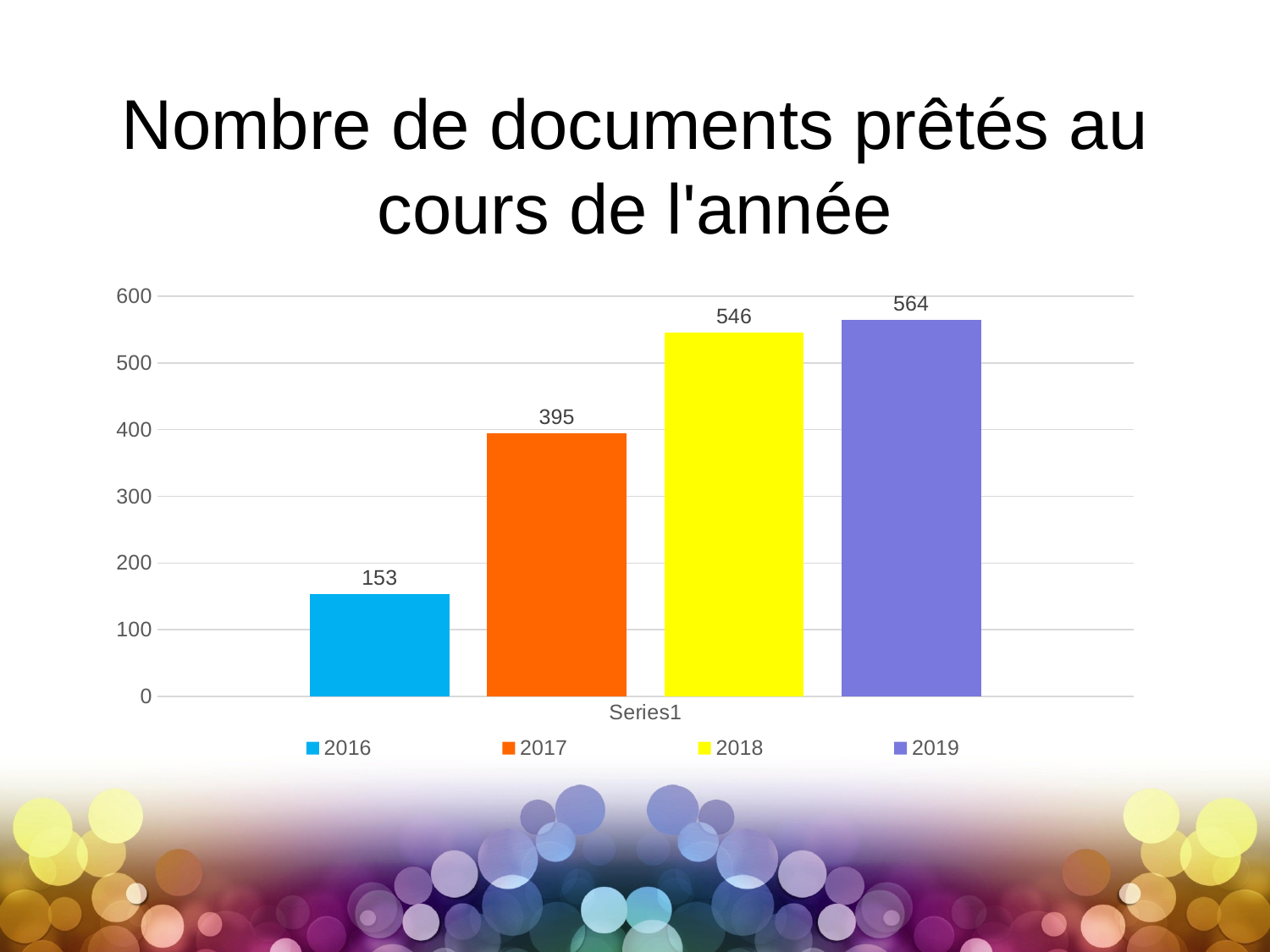
What is the difference between the values for 2017 and 2016? 242 What is the value for 2016? 153 What is the difference between the values for 2019 and 2018? 18 What kind of chart is shown on the slide? Bar chart Do the values rise or fall from 2016 to 2019? Rise What is the value for 2019? 564 Which year has the lowest value? 2016 How many bars are shown in the chart? 4 Which year has the highest value? 2019 What is the value for 2017? 395 What is the value for 2018? 546 Which is larger, the value for 2017 or the value for 2018? 2018